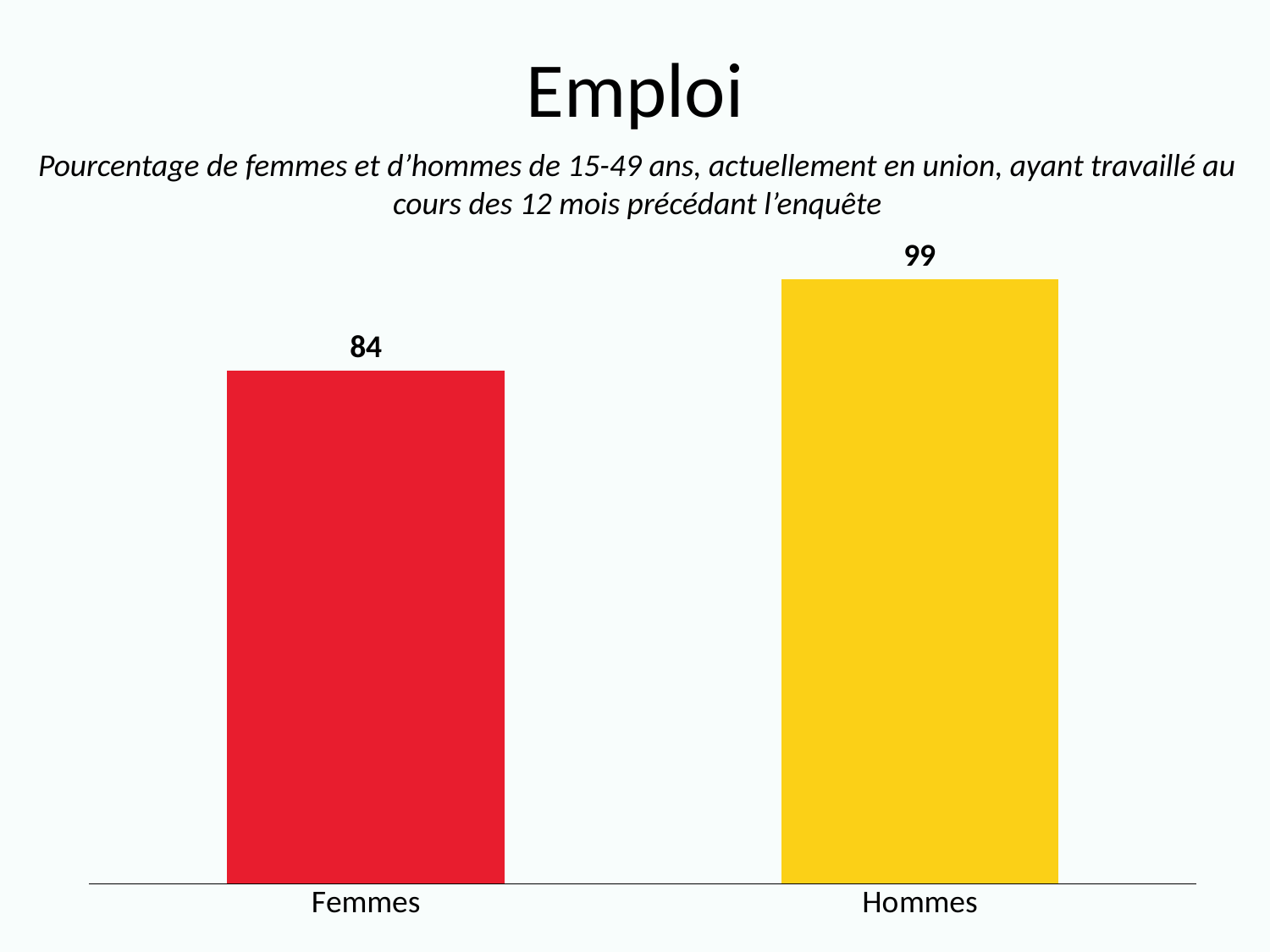
What is the value for Femmes? 84 What is the difference between the values for Hommes and Femmes? 15 Which category has the highest value? Hommes What kind of chart is shown on the slide? Bar chart What is the title of the slide? Emploi Which is larger, the value for Femmes or the value for Hommes? Hommes How many categories are shown in the chart? 2 What is the value for Hommes? 99 What colour is the bar for Hommes? Yellow Which category has the lowest value? Femmes